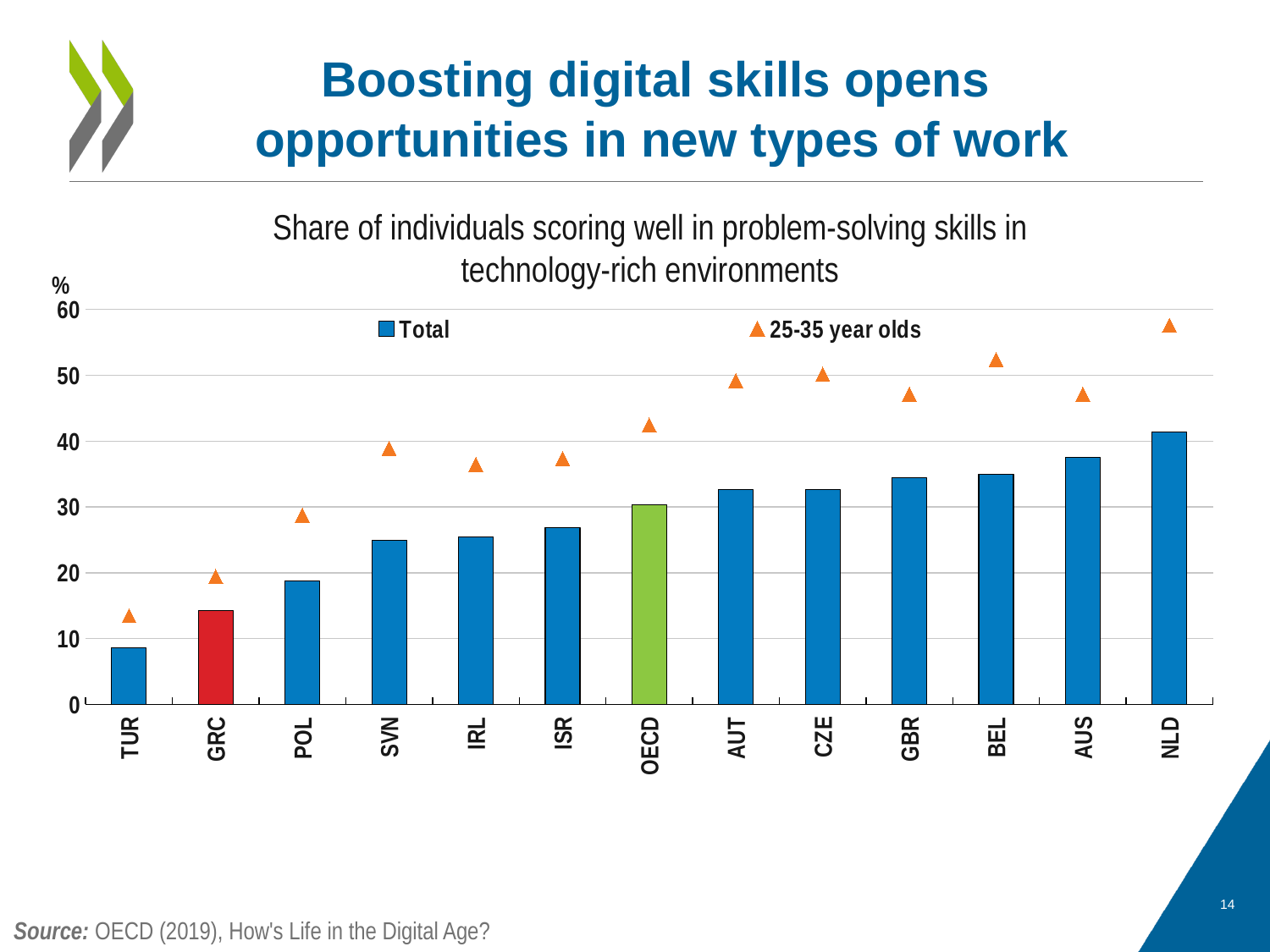
How many series does the legend list? 2 Is the value for 25-35 year olds in NLD greater or less than 50? greater How many countries/categories are shown on the x axis? 13 Which category has the highest value for 25-35 year olds? NLD For NLD, which is larger: the Total value or the value for 25-35 year olds? 25-35 year olds Which category has the lowest Total value? TUR Which category has the highest Total value? NLD Is the Total value for TUR greater or less than 10? less Is the Total value for POL greater or less than 20? less Which category's bar is coloured red? GRC Do the Total values rise or fall moving from left to right along the x axis? rise